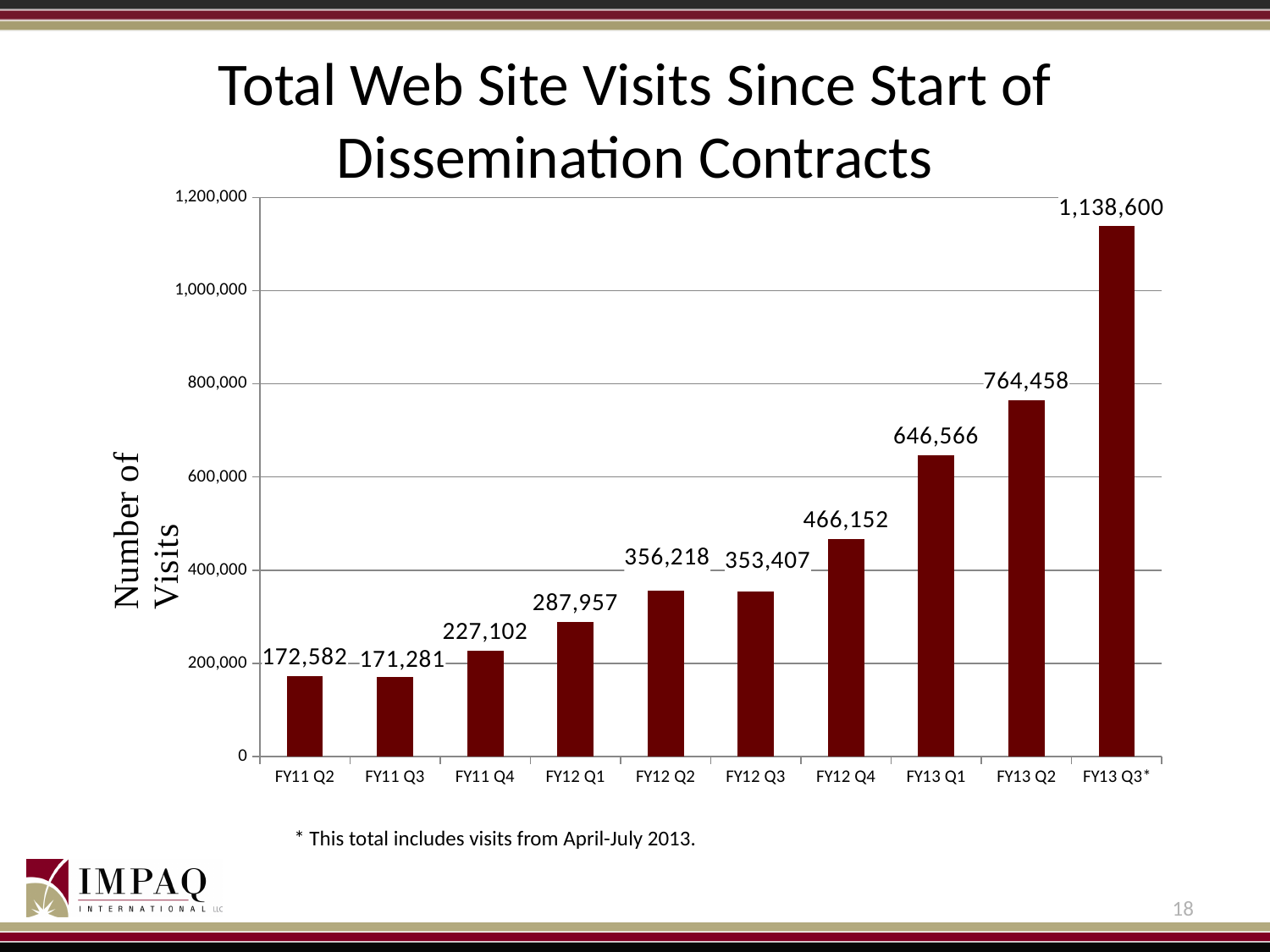
Which quarter has the lowest number of visits? FY11 Q3 What is the number of visits for FY13 Q1? 646,566 What kind of chart is shown on the slide? bar chart What is the number of visits for FY12 Q4? 466,152 Is the value for FY13 Q2 greater or less than 800,000? less What is the label of the y axis? Number of Visits What is the difference in visits between FY12 Q1 and FY11 Q4? 60,855 How many quarters are shown on the x axis? 10 Which has more visits, FY12 Q2 or FY12 Q3? FY12 Q2 What is the number of visits for FY11 Q4? 227,102 What is the difference in visits between FY13 Q3* and FY13 Q2? 374,142 Which quarter has the highest number of visits? FY13 Q3*